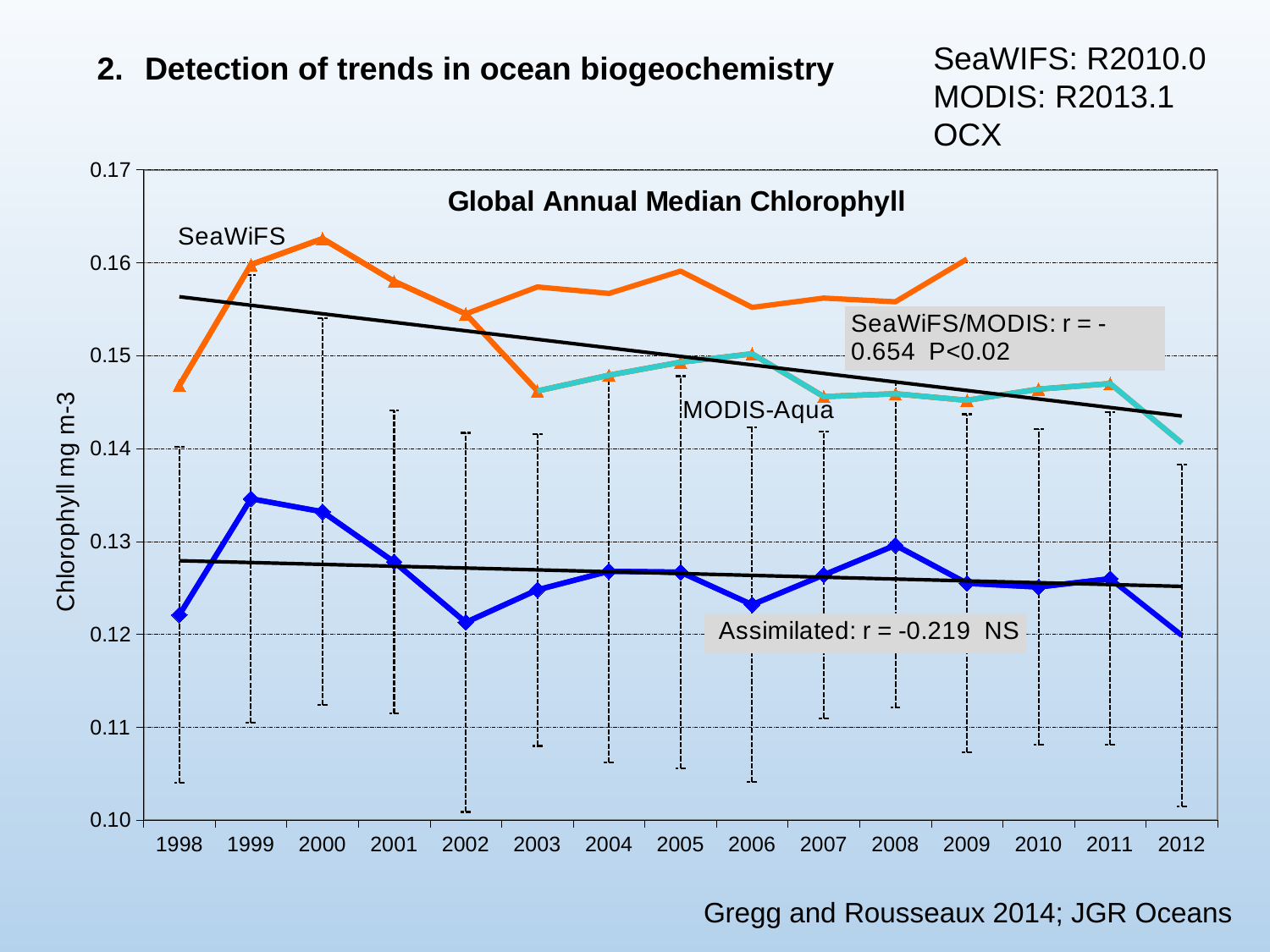
Is the SeaWiFS value for 2009 greater or less than 0.15? greater In which year does the SeaWiFS series reach its highest value? 2000 How many years are shown along the x axis of the chart? 15 Is the Assimilated value for 1998 greater or less than 0.13? less What is the title of the chart? Global Annual Median Chlorophyll What kind of chart is shown on the slide? line chart Which is larger in 1999, the SeaWiFS value or the Assimilated value? SeaWiFS Does the SeaWiFS/MODIS trend line rise or fall from 1998 to 2012? fall What correlation coefficient is reported for the Assimilated series on the chart? r = -0.219 NS Is the MODIS-Aqua value for 2012 greater or less than 0.15? less Which is larger for MODIS-Aqua, the value for 2006 or the value for 2007? 2006